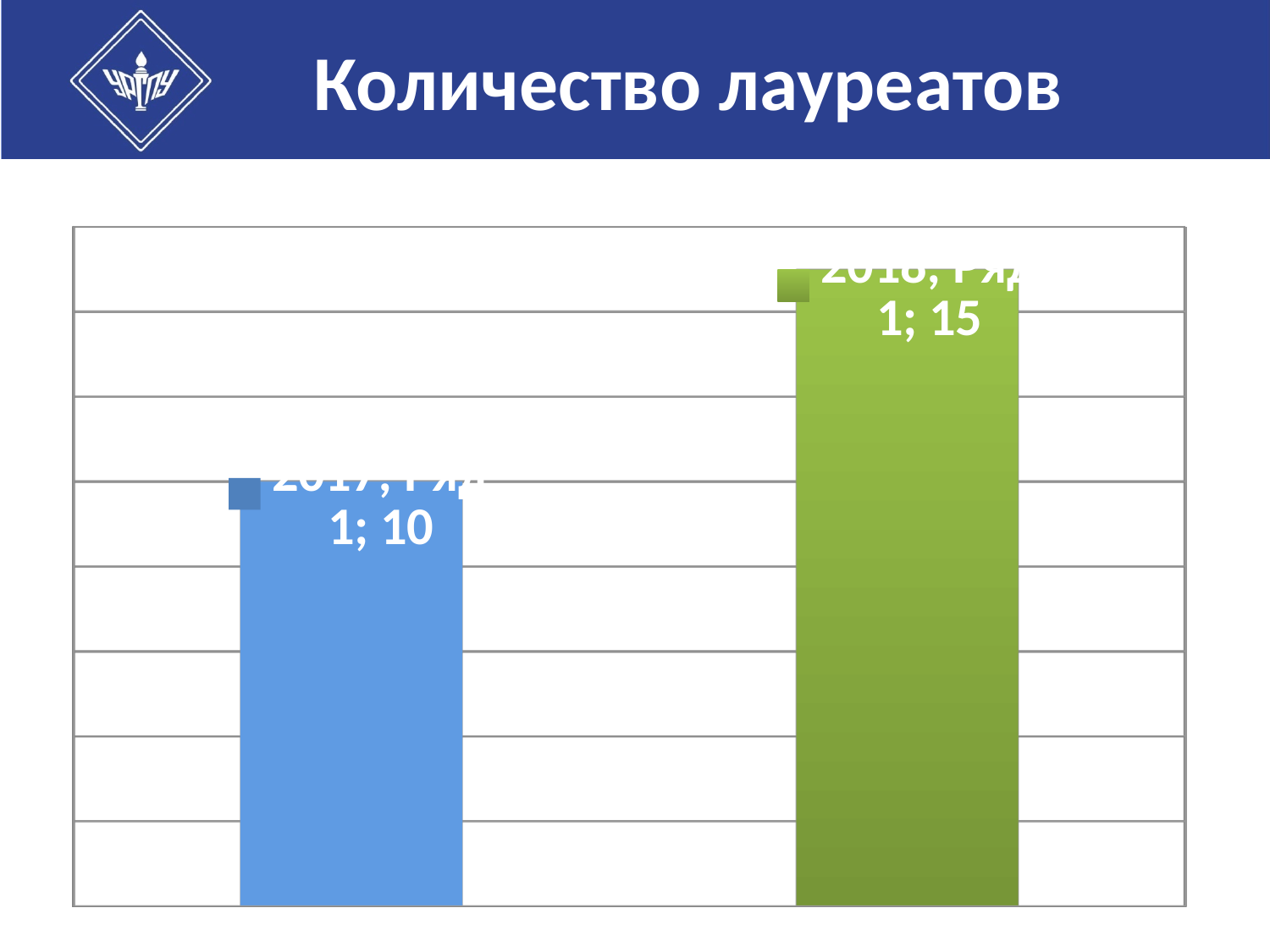
What is the title of the slide? Количество лауреатов What is the value for 2017? 10 How many bars are shown in the chart? 2 Is the value for 2018 larger or smaller than the value for 2017? larger Which year has the higher value? 2018 What is the difference between the values for 2018 and 2017? 5 Which year has the lower value? 2017 What kind of chart is shown on the slide? bar chart What colour is the bar for 2018? green Do the values rise or fall from 2017 to 2018? rise What is the value for 2018? 15